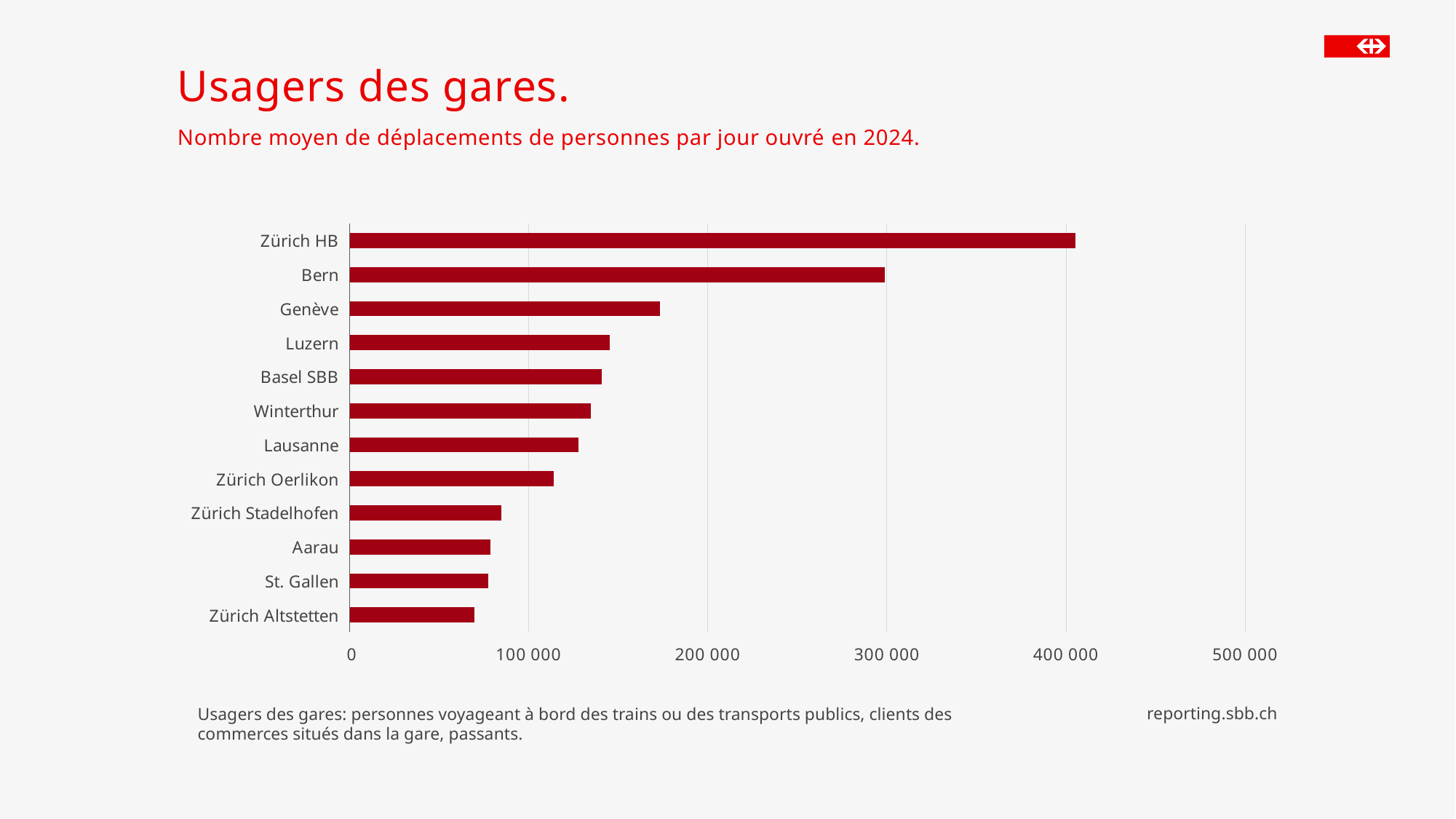
Which has more average daily users, Lausanne or Zürich Oerlikon? Lausanne How many stations are shown in the chart? 12 Which station has the highest number of average daily users? Zürich HB Is the value for Luzern greater or less than 100 000? greater Is the value for Zürich Oerlikon greater or less than 100 000? greater What kind of chart is shown on the slide? Bar chart Is the value for Genève greater or less than 200 000? less What is the title of the chart on the slide? Usagers des gares. Which station has the lowest number of average daily users? Zürich Altstetten Which has more average daily users, Bern or Genève? Bern